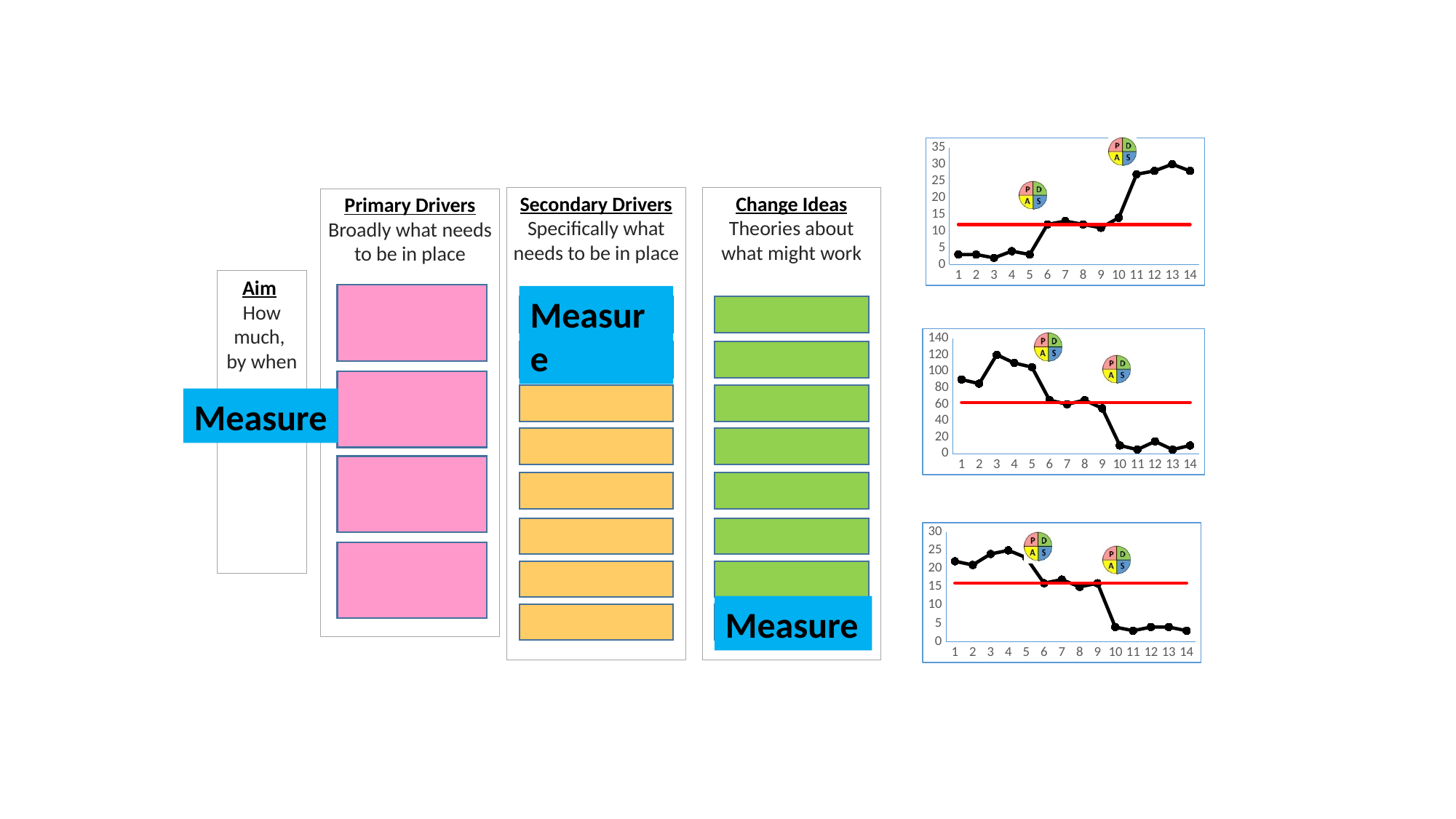
In the bottom chart on the right, is the value at point 12 greater or less than 10? less In the middle chart on the right, do the values generally rise or fall from point 1 to point 14? fall In the top chart on the right, is the value at point 13 greater or less than 25? greater In the top chart on the right, which is larger, the value at point 1 or the value at point 13? point 13 In the top chart on the right, is the value at point 1 greater or less than 5? less How many points are plotted along the x axis of the top chart on the right? 14 In the top chart on the right, do the values generally rise or fall from point 1 to point 14? rise In the middle chart on the right, which point has the highest value? 3 What kind of chart is the top chart on the right of the slide? line chart